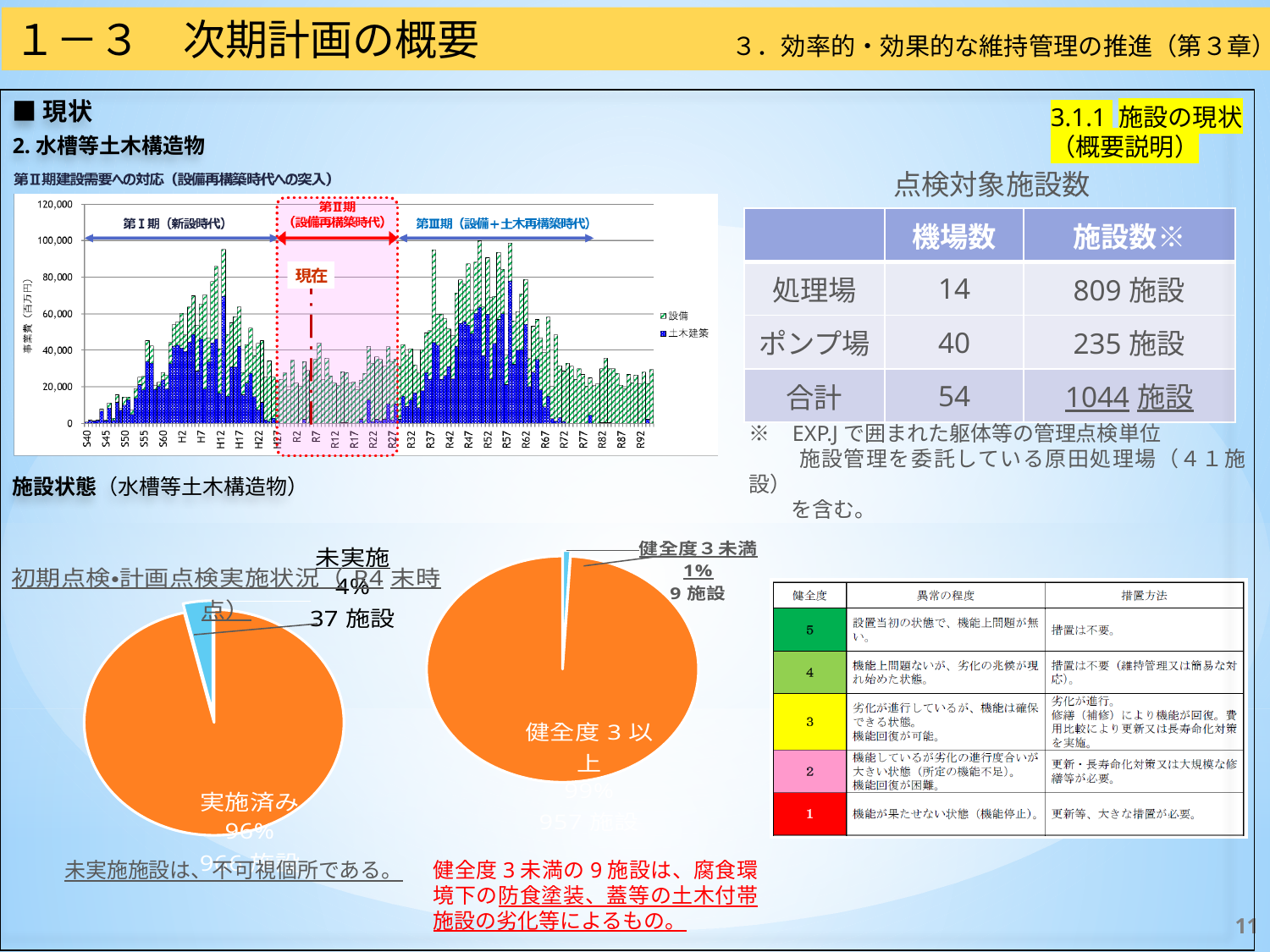
In the left pie chart (初期点検・計画点検実施状況), which slice is larger, 実施済み or 未実施? 実施済み In the left pie chart (初期点検・計画点検実施状況), what share is labelled 未実施? 4% In the right pie chart (健全度), what share is labelled 健全度3未満? 1% In the right pie chart (健全度), what share is labelled 健全度3以上? 99% In the left pie chart (初期点検・計画点検実施状況), how many facilities are labelled as 未実施? 37 施設 In the right pie chart (健全度), which slice is larger, 健全度3以上 or 健全度3未満? 健全度3以上 What kind of chart is the top-left chart (第Ⅱ期建設需要への対応)? bar chart In the left pie chart (初期点検・計画点検実施状況), how many slices does the pie have? 2 In the top-left chart (第Ⅱ期建設需要への対応), how many series does the legend list? 2 In the right pie chart (健全度), how many facilities are labelled as 健全度3未満? 9 施設 In the top-left chart (第Ⅱ期建設需要への対応), what are the two legend entries? 設備, 土木建築